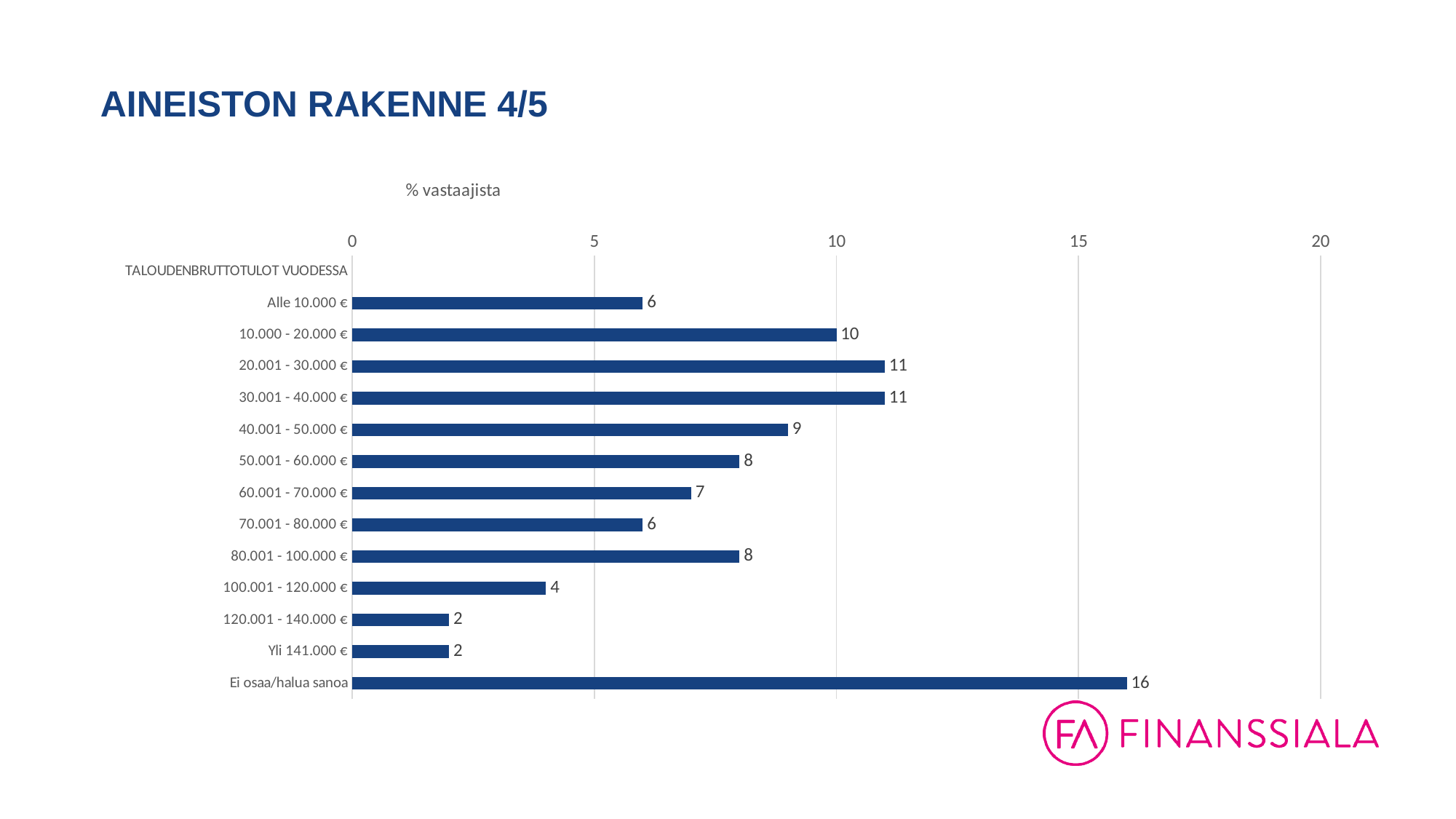
What is the value for "100.001 - 120.000 €"? 4 What is the difference between the values for "Ei osaa/halua sanoa" and "20.001 - 30.000 €"? 5 Which is larger, the value for "10.000 - 20.000 €" or the value for "60.001 - 70.000 €"? 10.000 - 20.000 € What is the difference between the values for "10.000 - 20.000 €" and "70.001 - 80.000 €"? 4 What is the value for "40.001 - 50.000 €"? 9 What is the title of the chart? % vastaajista How many bars are plotted in the chart? 13 Is the value for "Ei osaa/halua sanoa" greater or less than 15? greater Which category has the highest value? Ei osaa/halua sanoa What is the value for "Alle 10.000 €"? 6 What kind of chart is shown on the slide? bar chart What is the value for "Ei osaa/halua sanoa"? 16